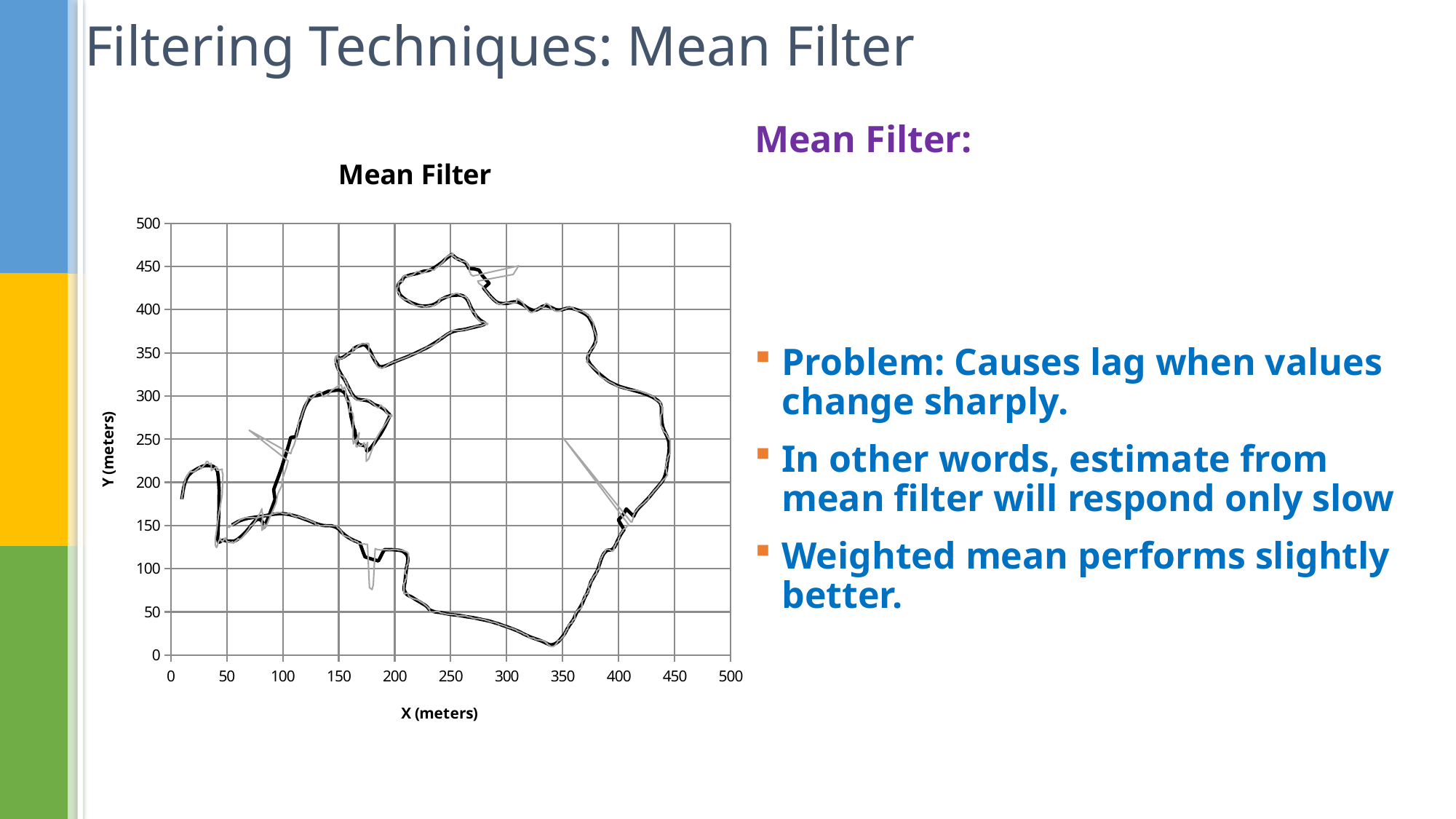
What is the label of the x axis of the chart? X (meters) Is the largest X value reached by the plotted path greater or less than 400? greater Is the highest Y value reached by the plotted path greater or less than 500? less Is the lowest Y value reached by the plotted path greater or less than 50? less What is the highest tick value shown on the x axis of the chart? 500 What is the spacing between consecutive tick marks on the y axis of the chart? 50 What kind of chart is shown on the slide? line chart What is the highest tick value shown on the y axis of the chart? 500 What is the title of the chart? Mean Filter